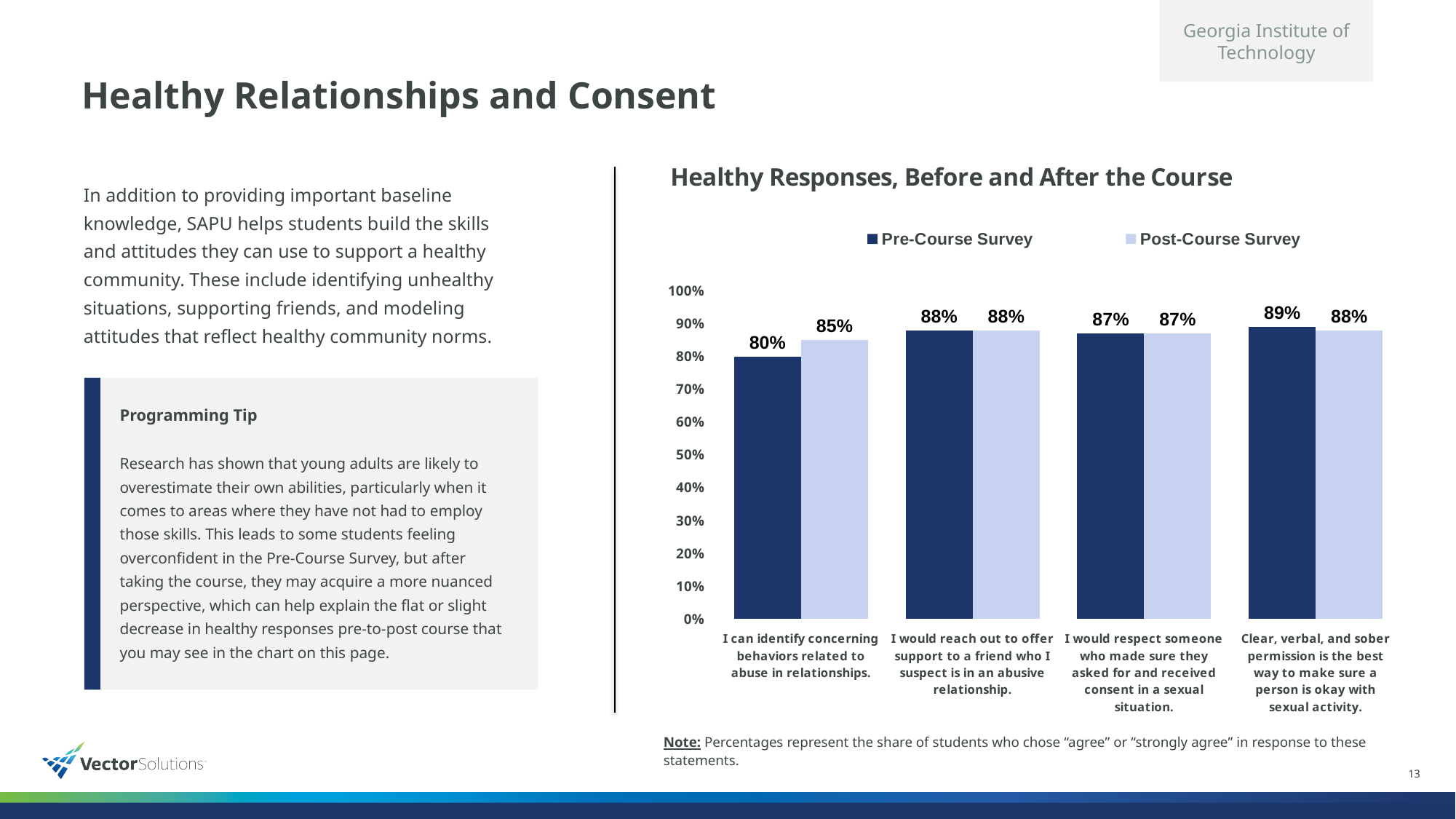
Which category has the highest Pre-Course Survey value? Clear, verbal, and sober permission is the best way to make sure a person is okay with sexual activity. What is the Pre-Course Survey value for "Clear, verbal, and sober permission is the best way to make sure a person is okay with sexual activity."? 89% What kind of chart is shown on the slide? Bar chart How many series does the legend list? 2 What is the Pre-Course Survey value for "I can identify concerning behaviors related to abuse in relationships."? 80% Which category has the lowest Pre-Course Survey value? I can identify concerning behaviors related to abuse in relationships. How many categories are shown on the x axis of the chart? 4 What is the Post-Course Survey value for "I can identify concerning behaviors related to abuse in relationships."? 85% What is the Post-Course Survey value for "I would respect someone who made sure they asked for and received consent in a sexual situation."? 87% What is the title of the chart? Healthy Responses, Before and After the Course What is the difference between the Post-Course and Pre-Course Survey values for "I can identify concerning behaviors related to abuse in relationships."? 5% For "Clear, verbal, and sober permission is the best way to make sure a person is okay with sexual activity.", which is larger: the Pre-Course Survey value or the Post-Course Survey value? Pre-Course Survey